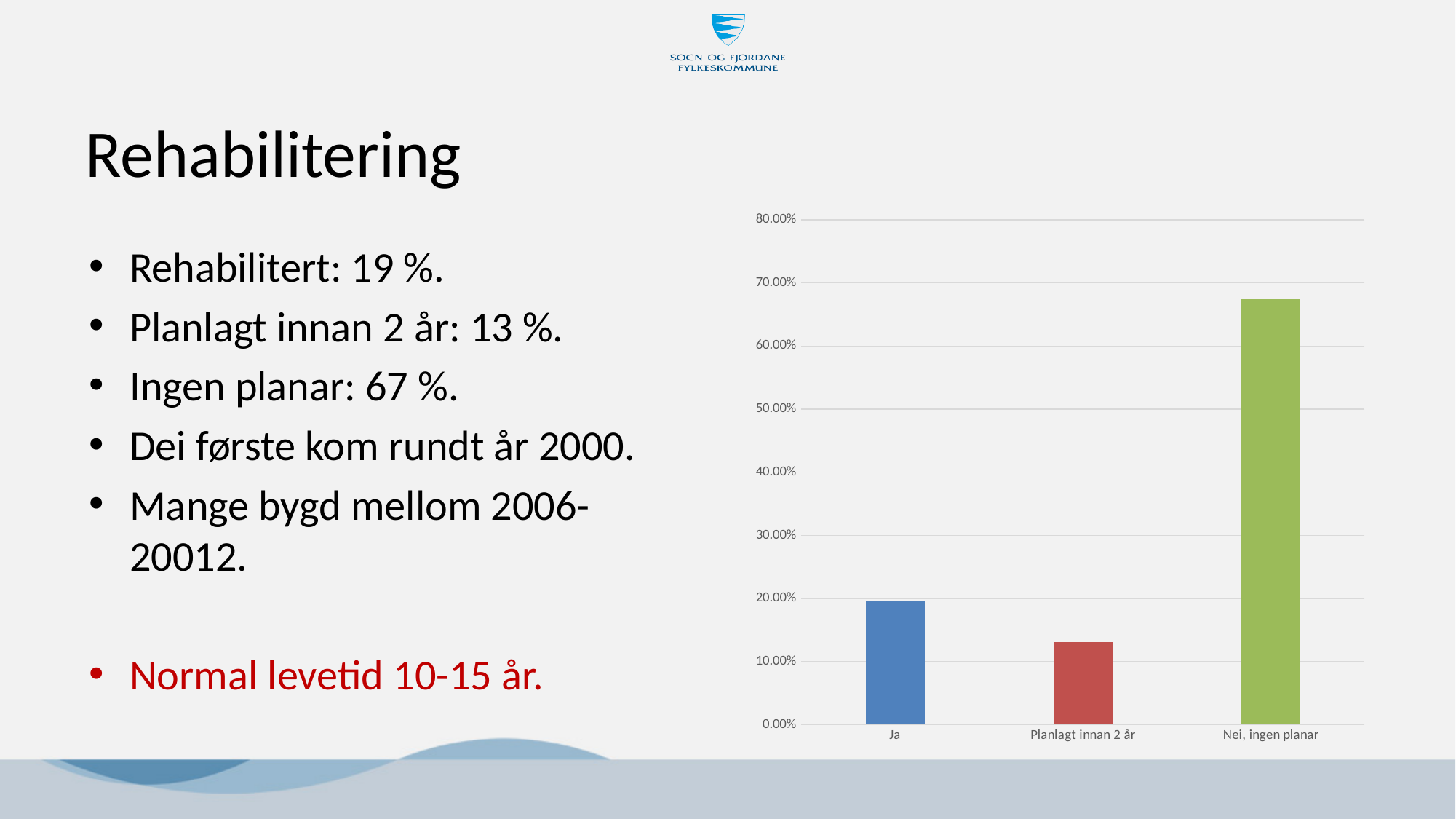
How many categories are shown on the x axis of the chart? 3 Which category has the highest bar in the chart? Nei, ingen planar What is the highest value shown on the chart's y axis? 80.00% What kind of chart is shown on the slide? bar chart Is the value for Nei, ingen planar greater or less than 70.00%? less What colour is the bar for Nei, ingen planar? green Is the value for Ja greater or less than 30.00%? less Which is larger, the value for Ja or the value for Planlagt innan 2 år? Ja Is the value for Planlagt innan 2 år greater or less than 20.00%? less Which category has the lowest bar in the chart? Planlagt innan 2 år